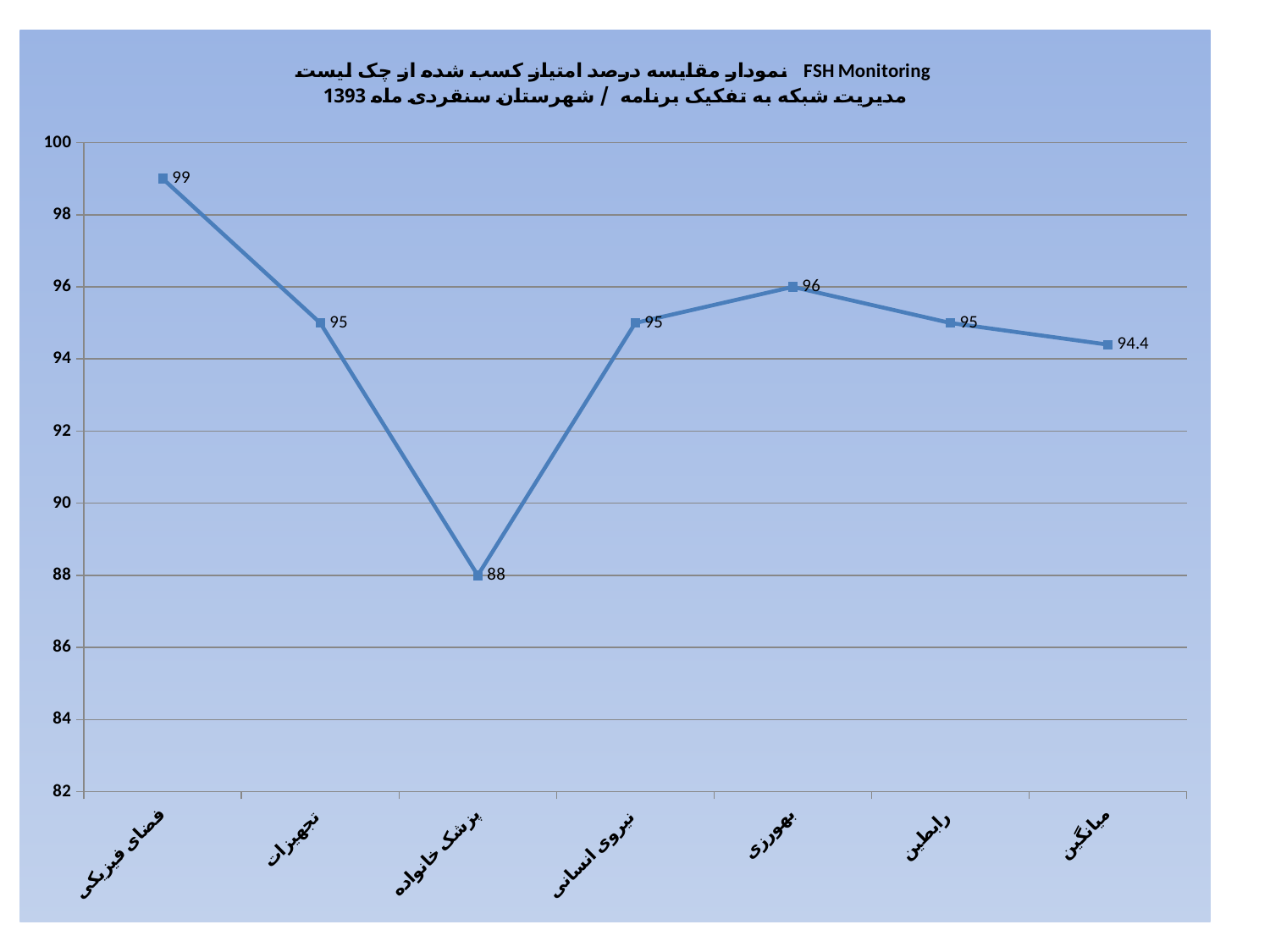
What is the difference between the values for بهورزی and میانگین? 1.6 What is the difference between the values for فضای فیزیکی and پزشک خانواده? 11 What is the value for میانگین? 94.4 Which category has the highest value? فضای فیزیکی Which category has the lowest value? پزشک خانواده What is the value for بهورزی? 96 What type of chart is shown on the slide? line chart Does the line rise or fall between تجهیزات and پزشک خانواده? fall What is the value for پزشک خانواده? 88 How many categories are plotted on the x axis? 7 Which is larger, the value for بهورزی or the value for رابطین? بهورزی What is the value for فضای فیزیکی? 99